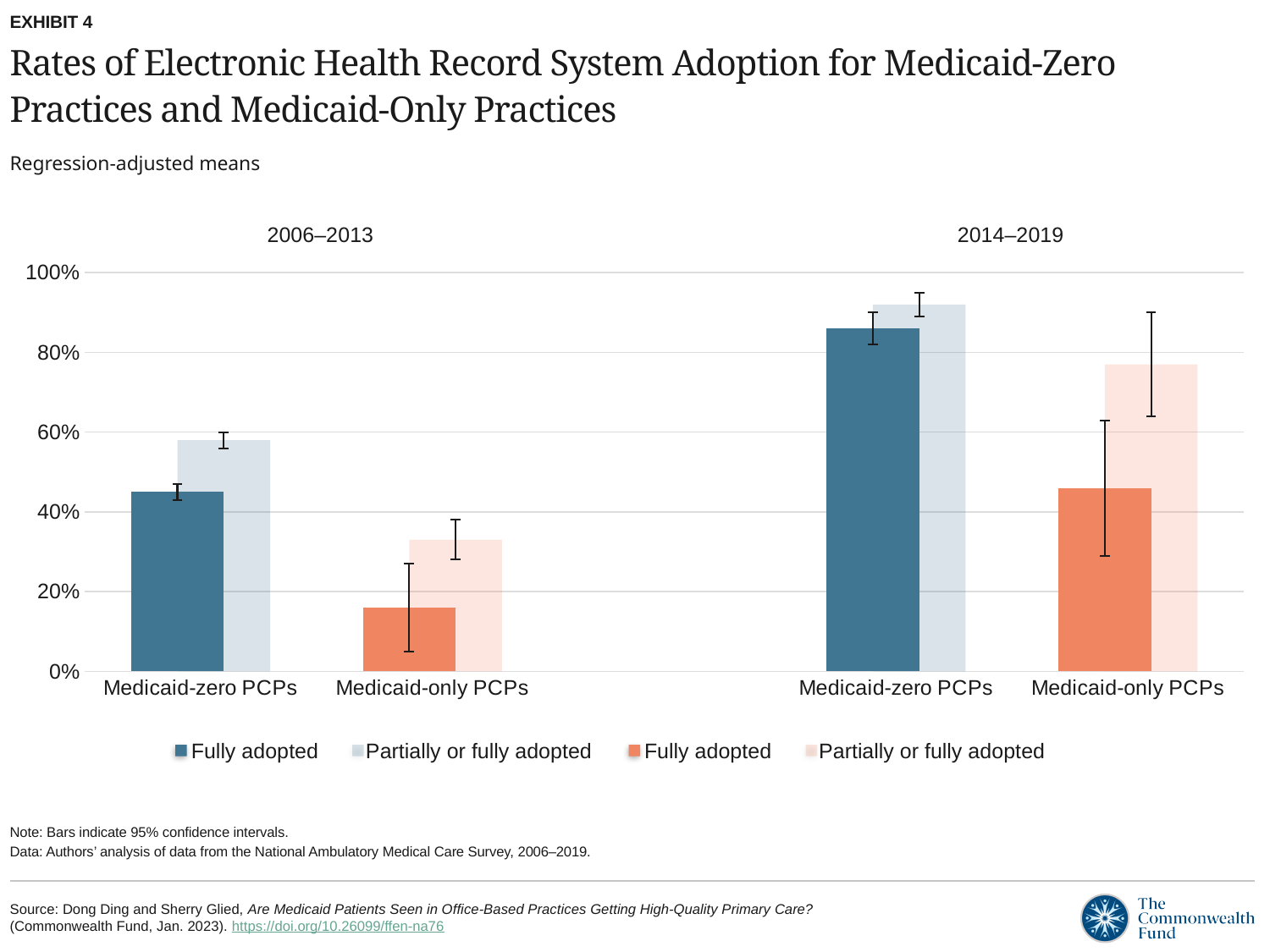
Is the 'Partially or fully adopted' value for Medicaid-zero PCPs in 2014–2019 greater or less than 80%? greater In 2006–2013, which has the higher 'Fully adopted' rate: Medicaid-zero PCPs or Medicaid-only PCPs? Medicaid-zero PCPs Which bar on the chart is the shortest? Fully adopted, Medicaid-only PCPs, 2006–2013 What kind of chart is shown on the slide? Bar chart How many time periods are shown on the chart? 2 Is the 'Fully adopted' value for Medicaid-only PCPs in 2014–2019 greater or less than 60%? less Is the 'Fully adopted' value for Medicaid-only PCPs in 2006–2013 greater or less than 20%? less How many entries does the legend list? 4 According to the note, what do the error bars on the chart indicate? 95% confidence intervals Which bar on the chart is the tallest? Partially or fully adopted, Medicaid-zero PCPs, 2014–2019